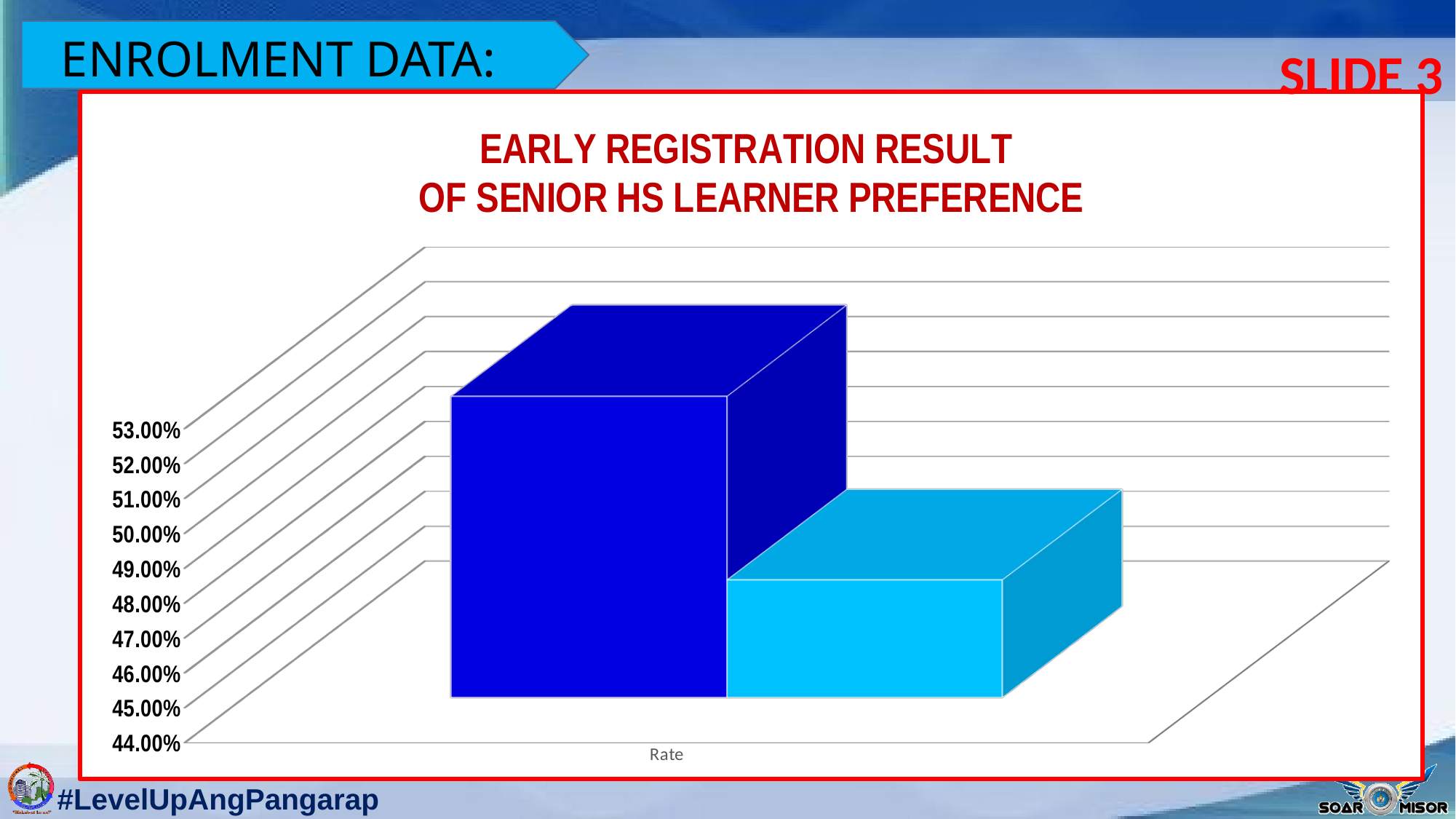
Which bar shows the lowest value in the chart? the light blue bar What kind of chart is shown on the slide? bar chart What is the highest value shown on the vertical axis of the chart? 53.00% How many bars are plotted in the chart? 2 Is the value of the light blue bar greater or less than 49.00%? less Is the value of the dark blue bar greater or less than 51.00%? greater What is the title of the chart? EARLY REGISTRATION RESULT OF SENIOR HS LEARNER PREFERENCE Is the value of the dark blue bar greater or less than 50.00%? greater Which bar is taller, the dark blue bar or the light blue bar? the dark blue bar What is the lowest value shown on the vertical axis of the chart? 44.00% What label appears on the horizontal axis of the chart? Rate